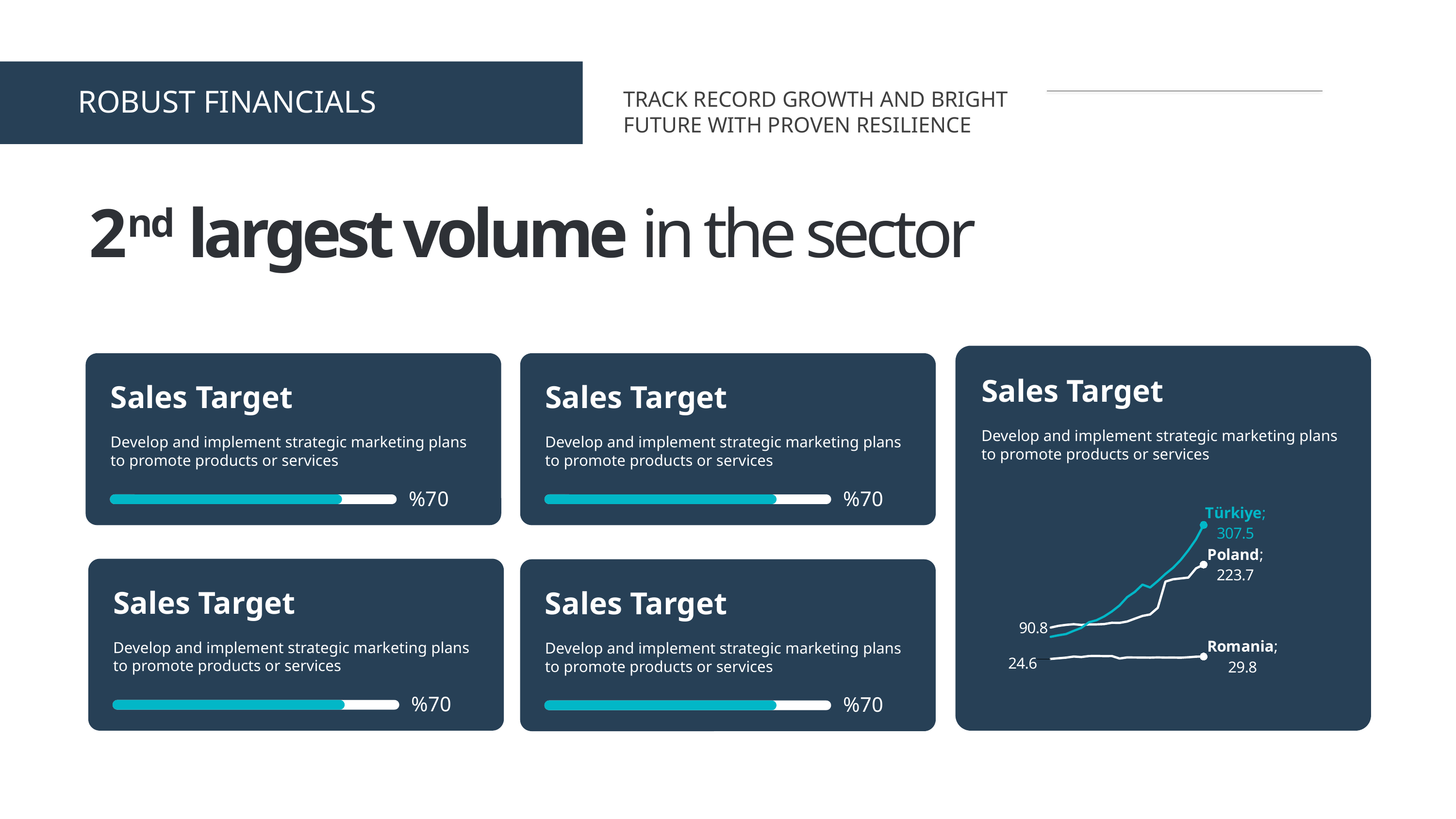
What kind of chart is shown in the right-hand 'Sales Target' panel? line chart Does Türkiye's line rise or fall from left to right in the line chart? rise Which line in the chart is drawn in teal rather than white? Türkiye How many lines (series) are plotted in the line chart? 3 By how much does Romania's line rise from its labelled start value to its labelled end value? 5.2 Which country has the lowest final value in the line chart? Romania What is the final labelled value for Romania in the line chart? 29.8 What is the starting value labelled for Romania's line in the line chart? 24.6 What is the final labelled value for Türkiye in the line chart? 307.5 Which country has the highest final value in the line chart? Türkiye What is the difference between the final values of Türkiye and Poland in the line chart? 83.8 What is the final labelled value for Poland in the line chart? 223.7